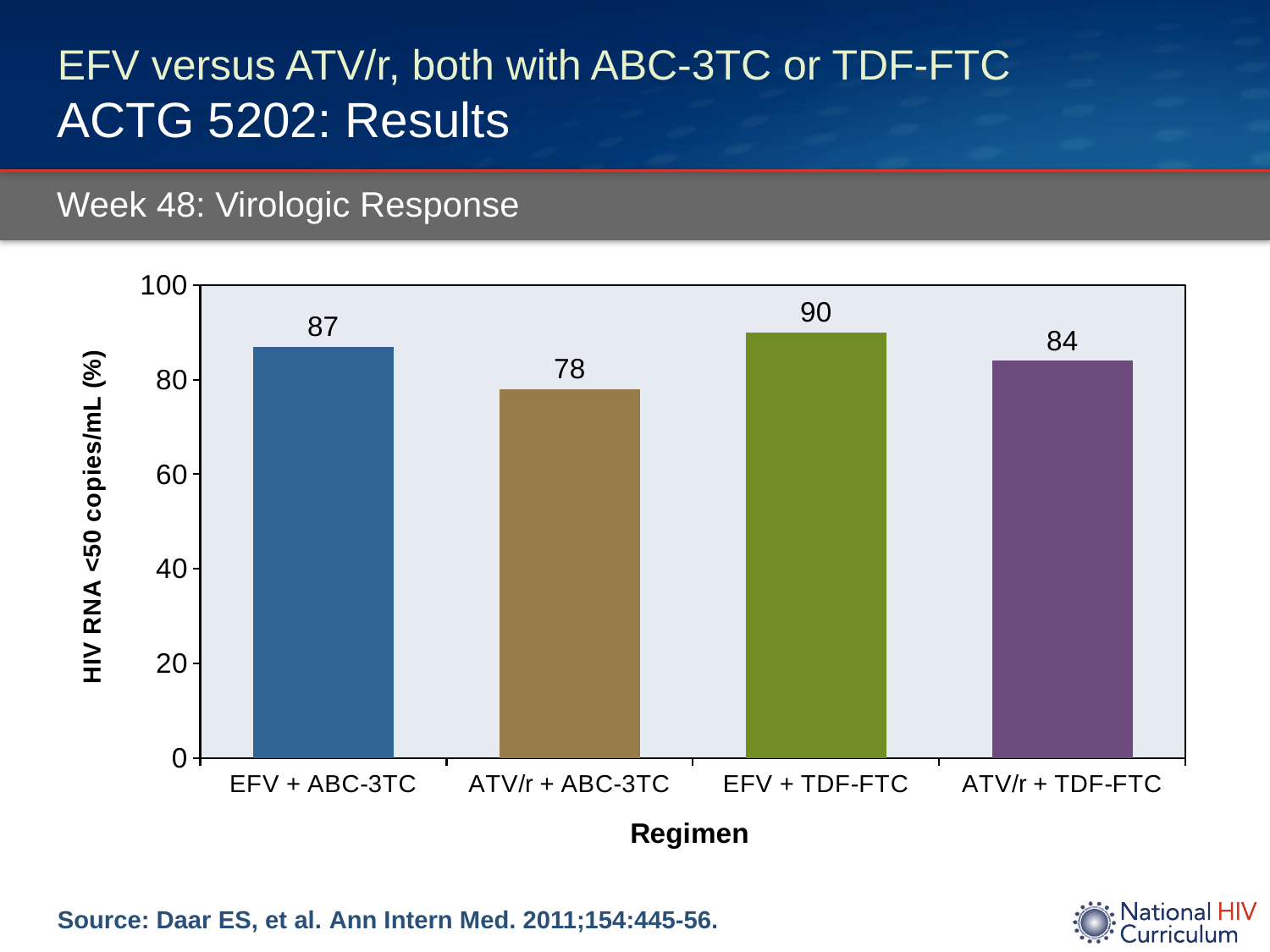
What is the value for ATV/r + ABC-3TC? 78 What is the value for ATV/r + TDF-FTC? 84 Which regimen has the lowest virologic response? ATV/r + ABC-3TC What is the label of the y axis? HIV RNA <50 copies/mL (%) What is the value for EFV + ABC-3TC? 87 What kind of chart is shown on the slide? Bar chart Which regimen has the highest virologic response? EFV + TDF-FTC What is the difference between the values for EFV + TDF-FTC and ATV/r + TDF-FTC? 6 How many regimens are shown on the chart? 4 What is the difference between the values for EFV + ABC-3TC and ATV/r + ABC-3TC? 9 What is the value for EFV + TDF-FTC? 90 Which is larger, the value for EFV + ABC-3TC or the value for ATV/r + TDF-FTC? EFV + ABC-3TC